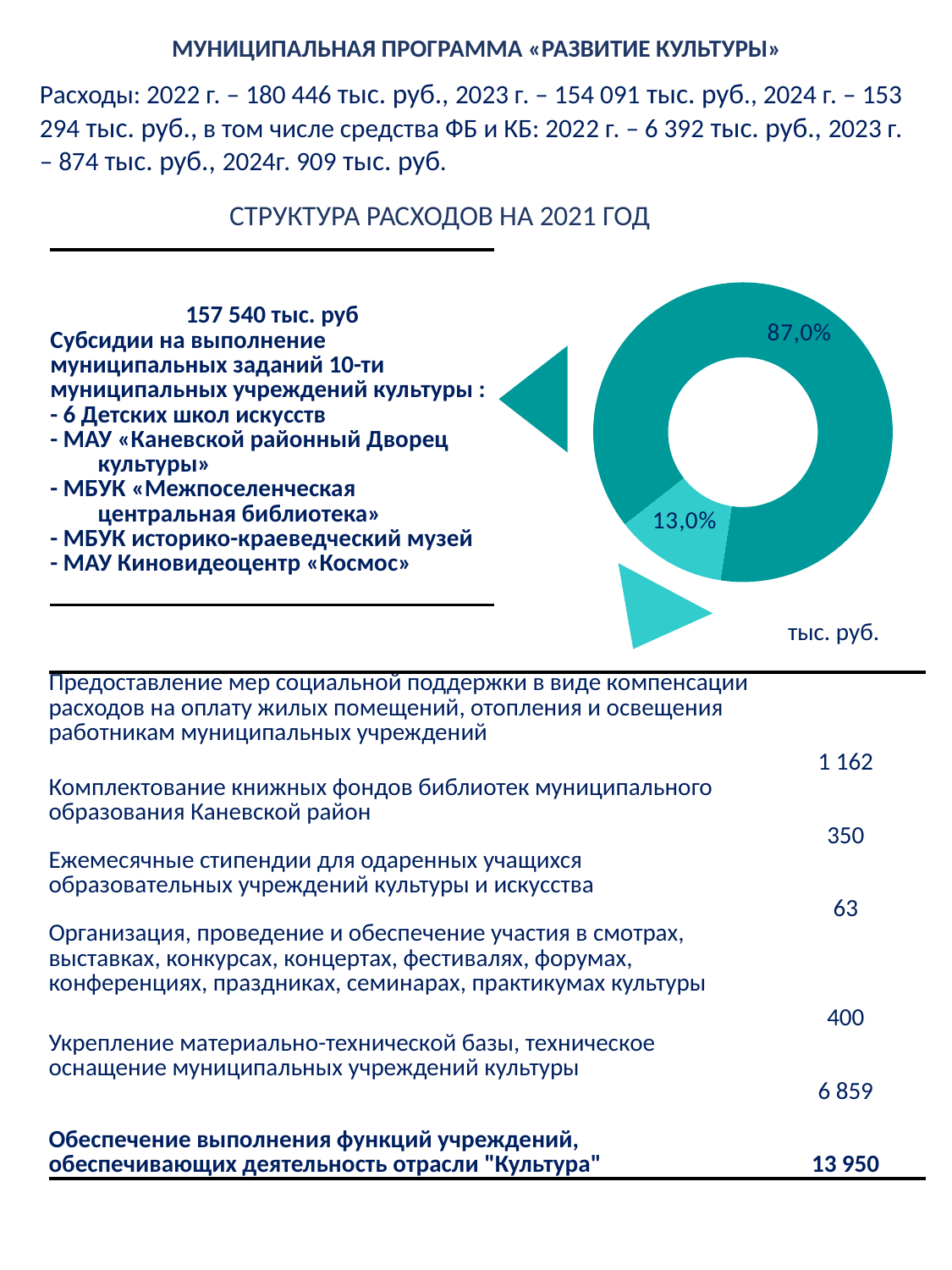
What is the title of the chart on the slide? СТРУКТУРА РАСХОДОВ НА 2021 ГОД How many slices does the donut chart have? 2 Is the smaller slice of the donut chart greater or less than 25%? less What kind of chart is shown on the slide? Donut (pie) chart Do the two slices of the donut chart add up to 100%? Yes What unit is indicated below the donut chart? тыс. руб. What is the share of the smallest slice in the donut chart? 13,0% What is the share of the largest slice in the donut chart? 87,0% Is the larger slice of the donut chart greater or less than 50%? greater What is the difference in percentage points between the two slices of the donut chart? 74,0%